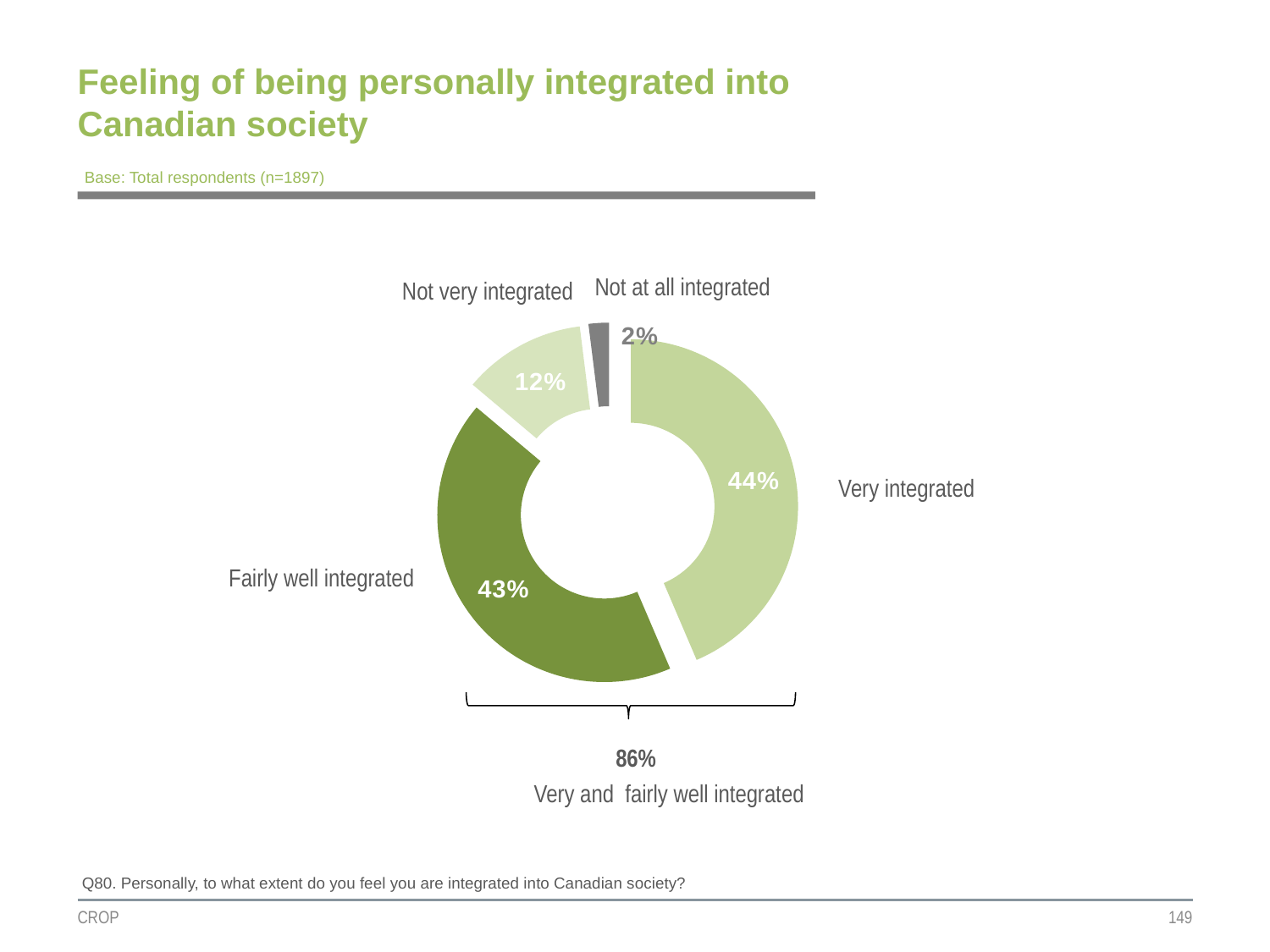
What is the difference between the share for not very integrated and not at all integrated? 10 percentage points Which category has the smallest share of the chart? Not at all integrated What combined percentage is shown for very and fairly well integrated? 86% What is the base (number of respondents) stated for the chart? Total respondents (n=1897) Which category has the largest share of the chart? Very integrated How many categories are shown in the chart? 4 What percentage of respondents feel very integrated into Canadian society? 44% What kind of chart is shown on the slide? Doughnut chart What percentage of respondents feel not very integrated? 12% What percentage of respondents feel fairly well integrated? 43% Which is larger, the share for fairly well integrated or the share for not very integrated? Fairly well integrated What percentage of respondents feel not at all integrated? 2%